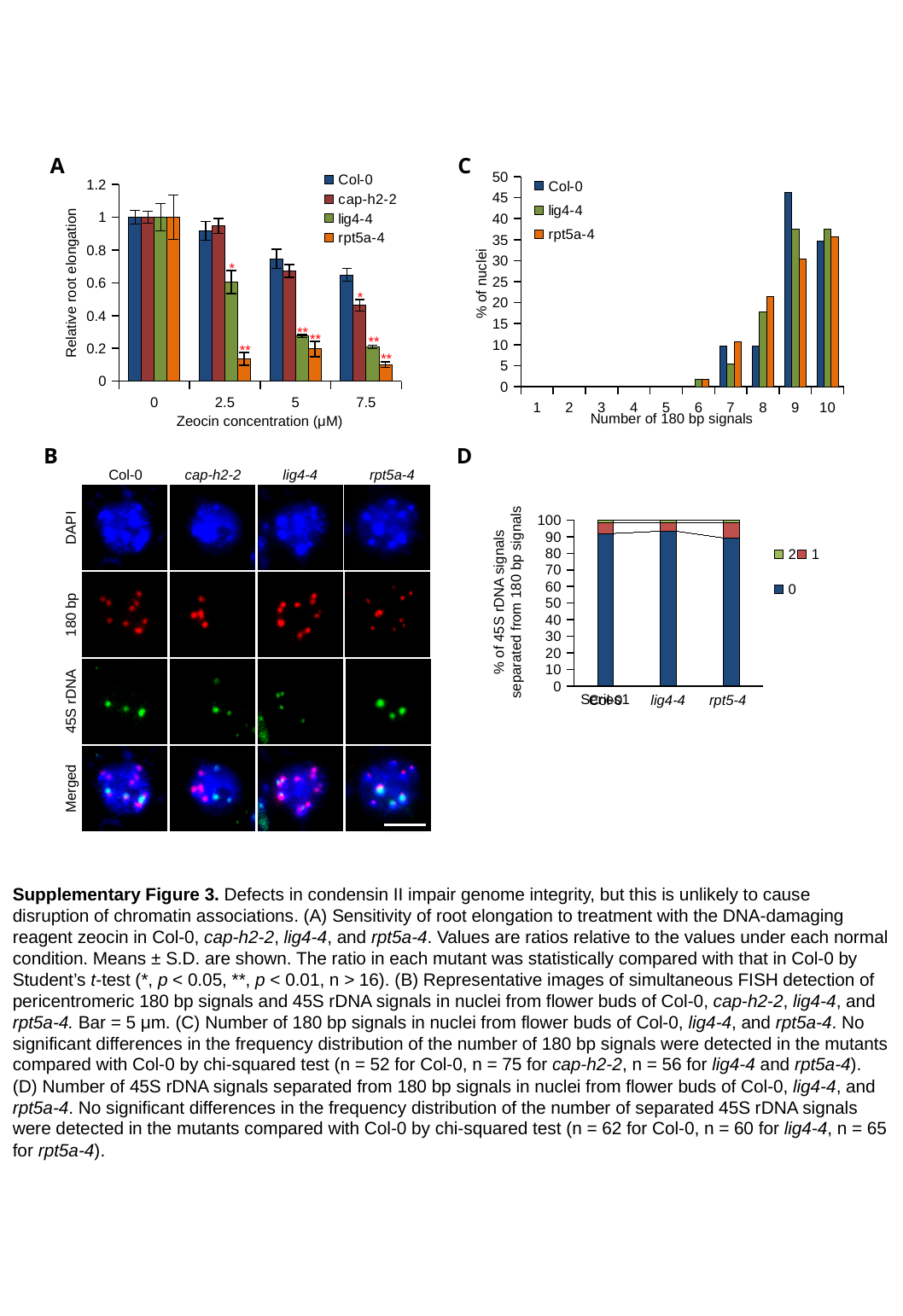
In chart A (Relative root elongation), does the Col-0 value rise or fall as zeocin concentration increases? fall In chart A (Relative root elongation), how many zeocin concentrations are shown on the x axis? 4 In chart A (Relative root elongation), is the value for rpt5a-4 at 2.5 µM greater or less than 0.2? less In chart A (Relative root elongation), how many series does the legend list? 4 In chart C (% of nuclei), how many series does the legend list? 3 In chart D (% of 45S rDNA signals separated from 180 bp signals), how many series does the legend list? 3 In chart A (Relative root elongation), what is the value for Col-0 at zeocin concentration 0? 1 In chart C (% of nuclei), is the Col-0 value at 9 signals greater or less than 40? greater In chart A (Relative root elongation), at 7.5 µM, which is larger: Col-0 or rpt5a-4? Col-0 In chart C (% of nuclei), at which number of 180 bp signals is the Col-0 value highest? 9 In chart C (% of nuclei), at 8 signals, which is larger: Col-0 or rpt5a-4? rpt5a-4 What kind of chart is chart A (Relative root elongation)? bar chart